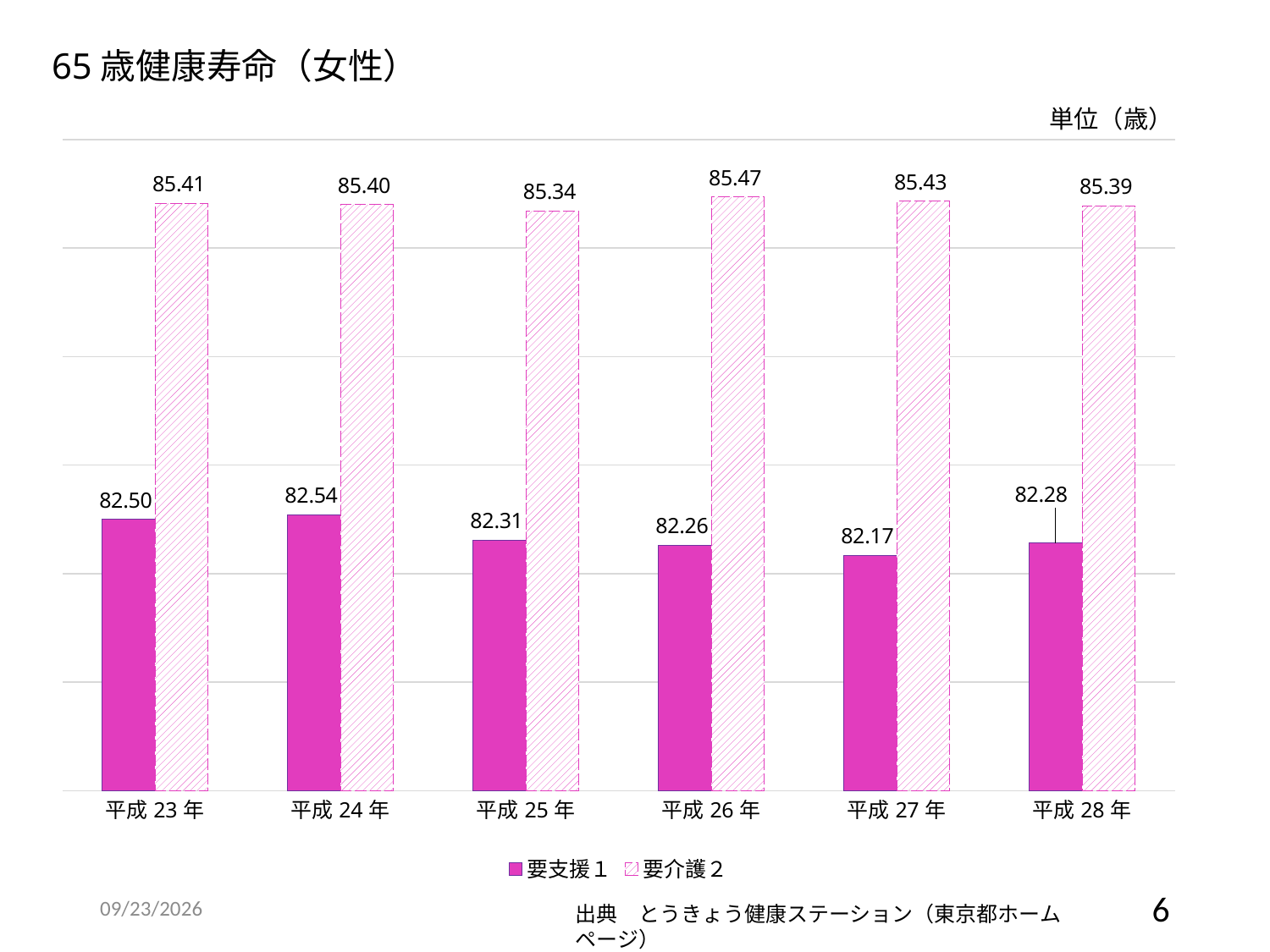
What is the value for 要支援１ in 平成 27 年? 82.17 What is the value for 要介護２ in 平成 28 年? 85.39 What is the value for 要支援１ in 平成 23 年? 82.50 What kind of chart is shown on the slide? bar chart How many series does the legend list? 2 Which year has the highest value for 要介護２? 平成 26 年 Which year has the highest value for 要支援１? 平成 24 年 Which year has the lowest value for 要支援１? 平成 27 年 What is the value for 要介護２ in 平成 26 年? 85.47 What is the difference between 要介護２ and 要支援１ in 平成 25 年? 3.03 How many years are shown on the x axis? 6 Which is larger in 平成 24 年: 要支援１ or 要介護２? 要介護２